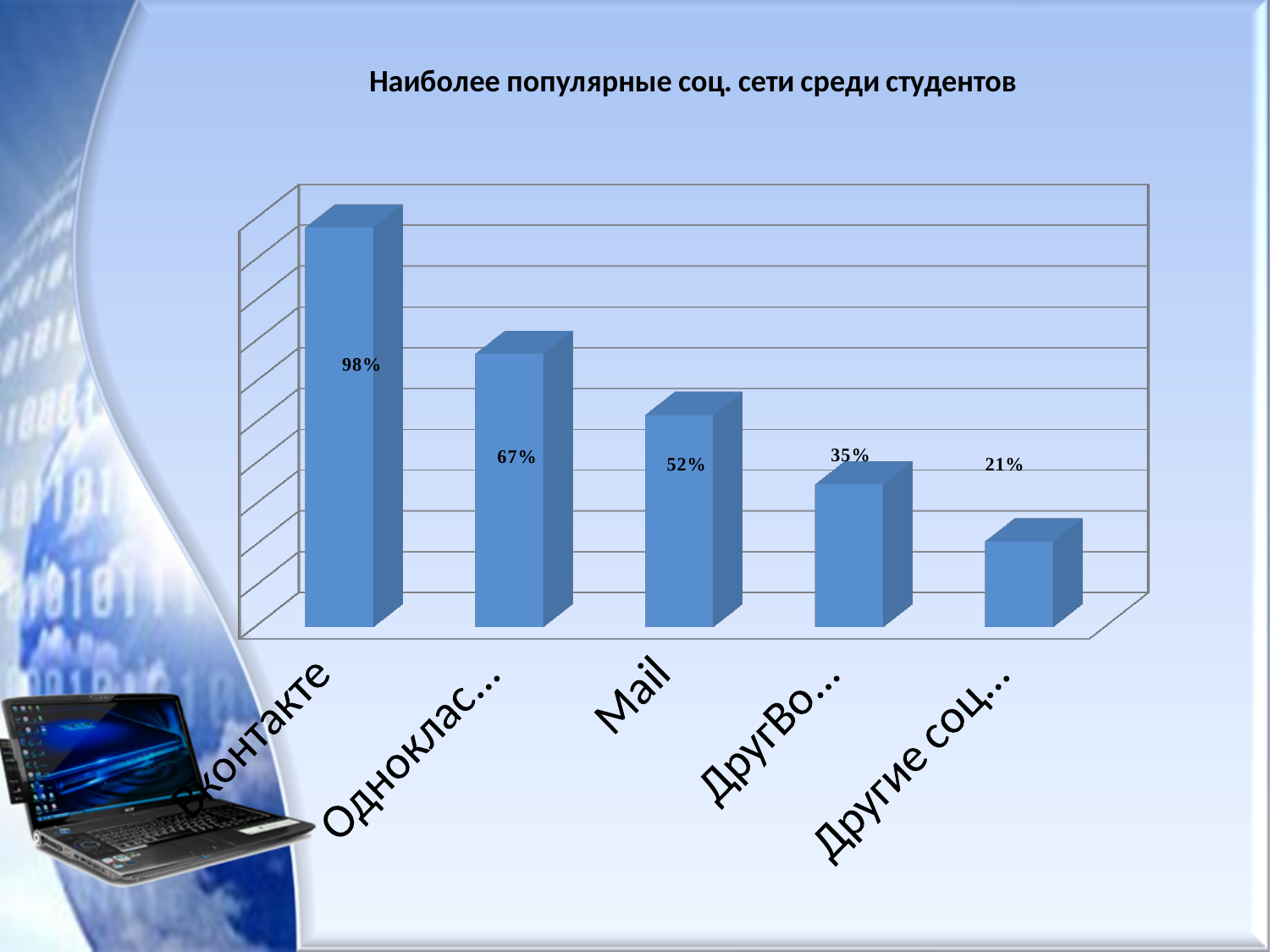
What is the value for the category labelled "Другие соц..."? 21% How many categories are shown in the chart? 5 What is the value for Вконтакте? 98% What is the title of the chart? Наиболее популярные соц. сети среди студентов What is the value for Mail? 52% What is the difference between the values for Вконтакте and Mail? 46% Which category has the highest value? Вконтакте Which category has the lowest value? Другие соц... What kind of chart is shown on the slide? Bar chart What is the value for the category labelled "Одноклас..."? 67% What is the value for the category labelled "ДругВо..."? 35% Which is larger, the value for Mail or the value for "ДругВо..."? Mail